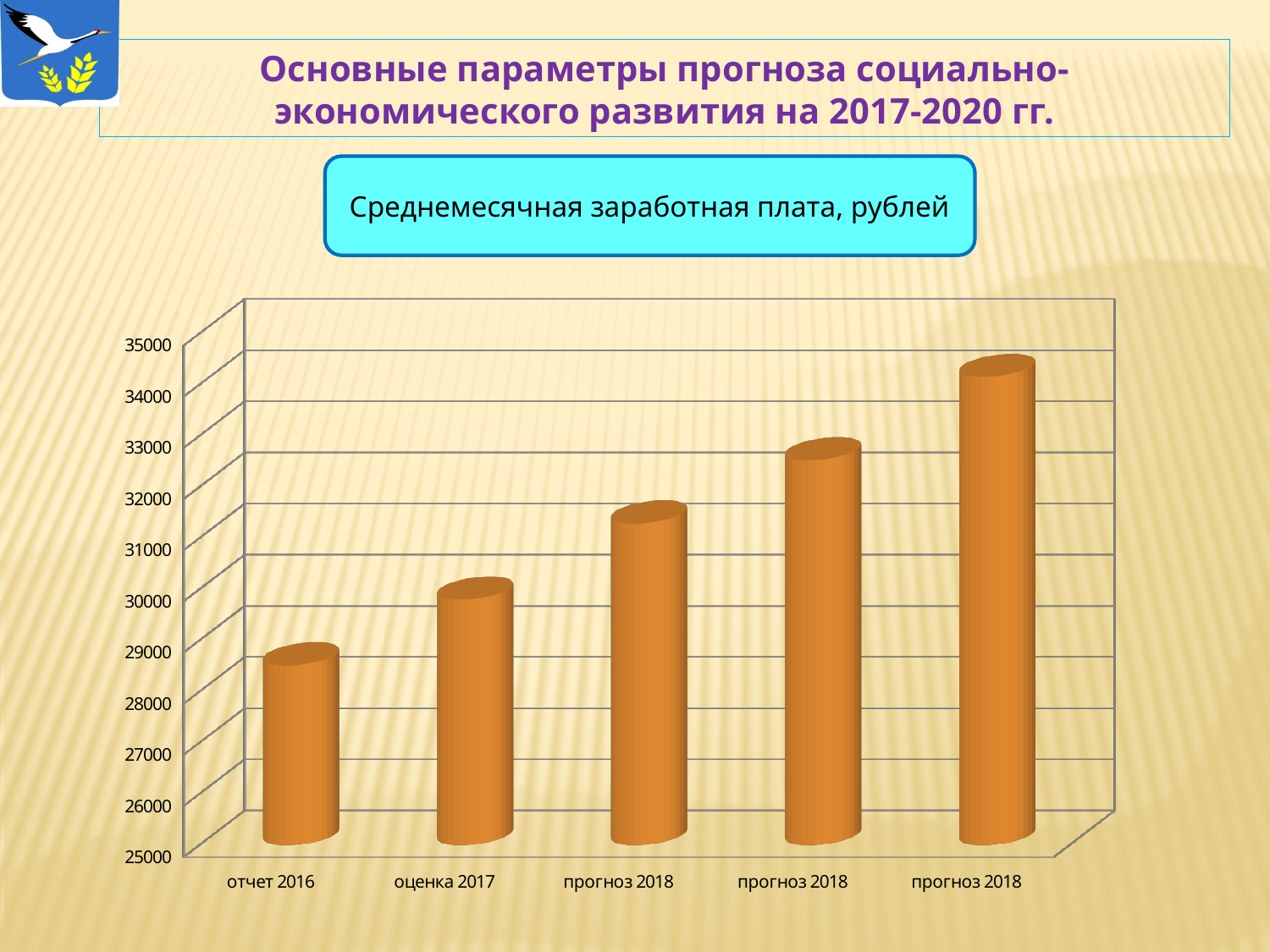
Is the value for отчет 2016 greater or less than 30000? less Is the value for отчет 2016 greater or less than 28000? greater Which bar has the highest value? the rightmost bar (прогноз 2018) Is the value of the middle (third) bar greater or less than 31000? greater Which category has the lowest value? отчет 2016 What kind of chart is shown on the slide? bar chart What is the title shown above the chart? Среднемесячная заработная плата, рублей Do the values rise or fall from left to right along the x axis? rise How many bars are plotted in the chart? 5 Which is larger, the value for отчет 2016 or the value for оценка 2017? оценка 2017